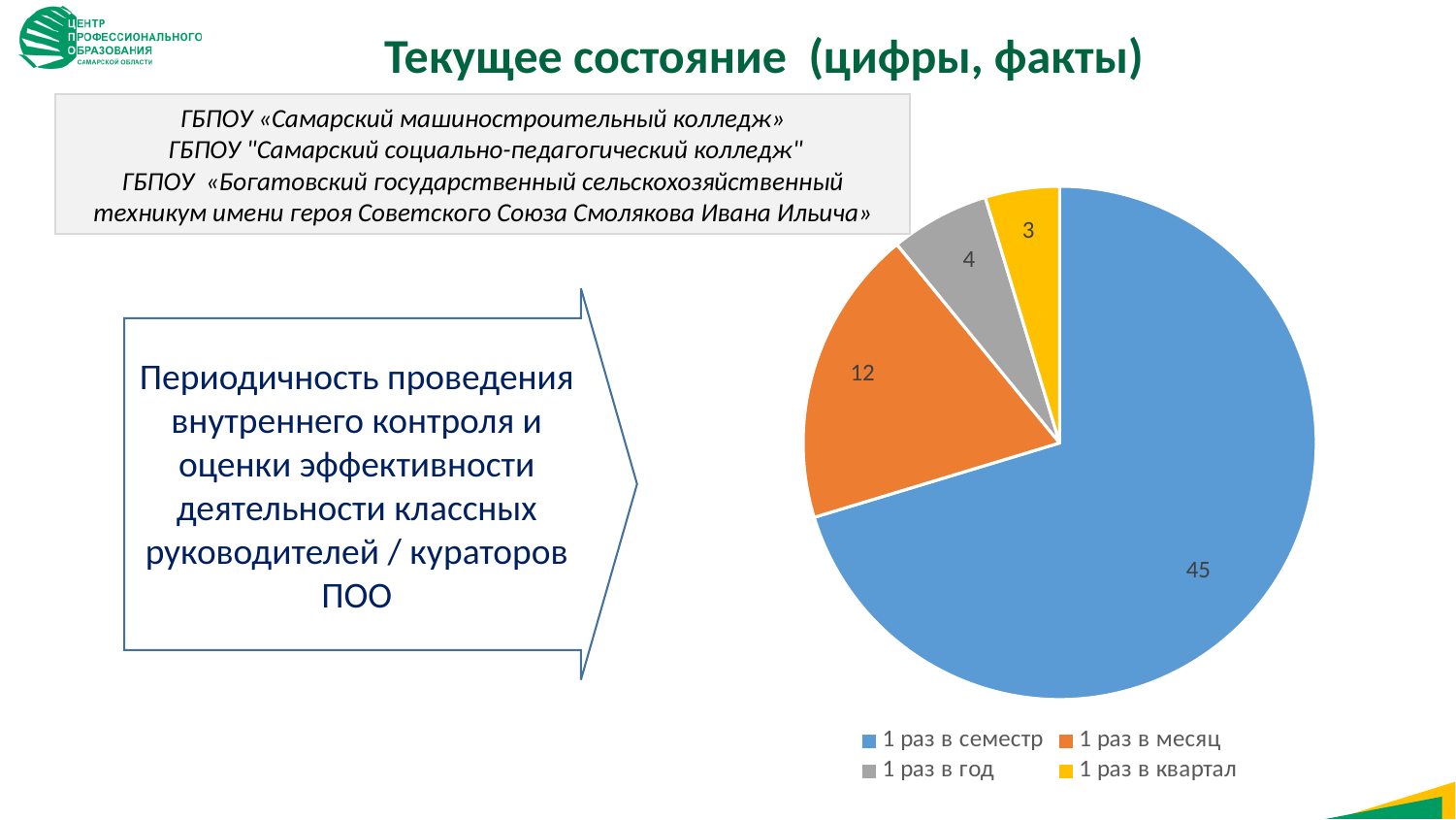
Which is larger: the value for "1 раз в год" or the value for "1 раз в квартал"? 1 раз в год How many slices does the pie chart have? 4 What is the difference between the values for "1 раз в семестр" and "1 раз в месяц"? 33 What type of chart is shown on the slide? Pie chart Which category has the smallest slice in the pie chart? 1 раз в квартал What colour is the "1 раз в месяц" slice in the pie chart? Orange What value is shown for the "1 раз в квартал" slice of the pie chart? 3 Which category has the largest slice in the pie chart? 1 раз в семестр What is the total of all the values shown in the pie chart? 64 What value is shown for the "1 раз в год" slice of the pie chart? 4 What value is shown for the "1 раз в семестр" slice of the pie chart? 45 What value is shown for the "1 раз в месяц" slice of the pie chart? 12